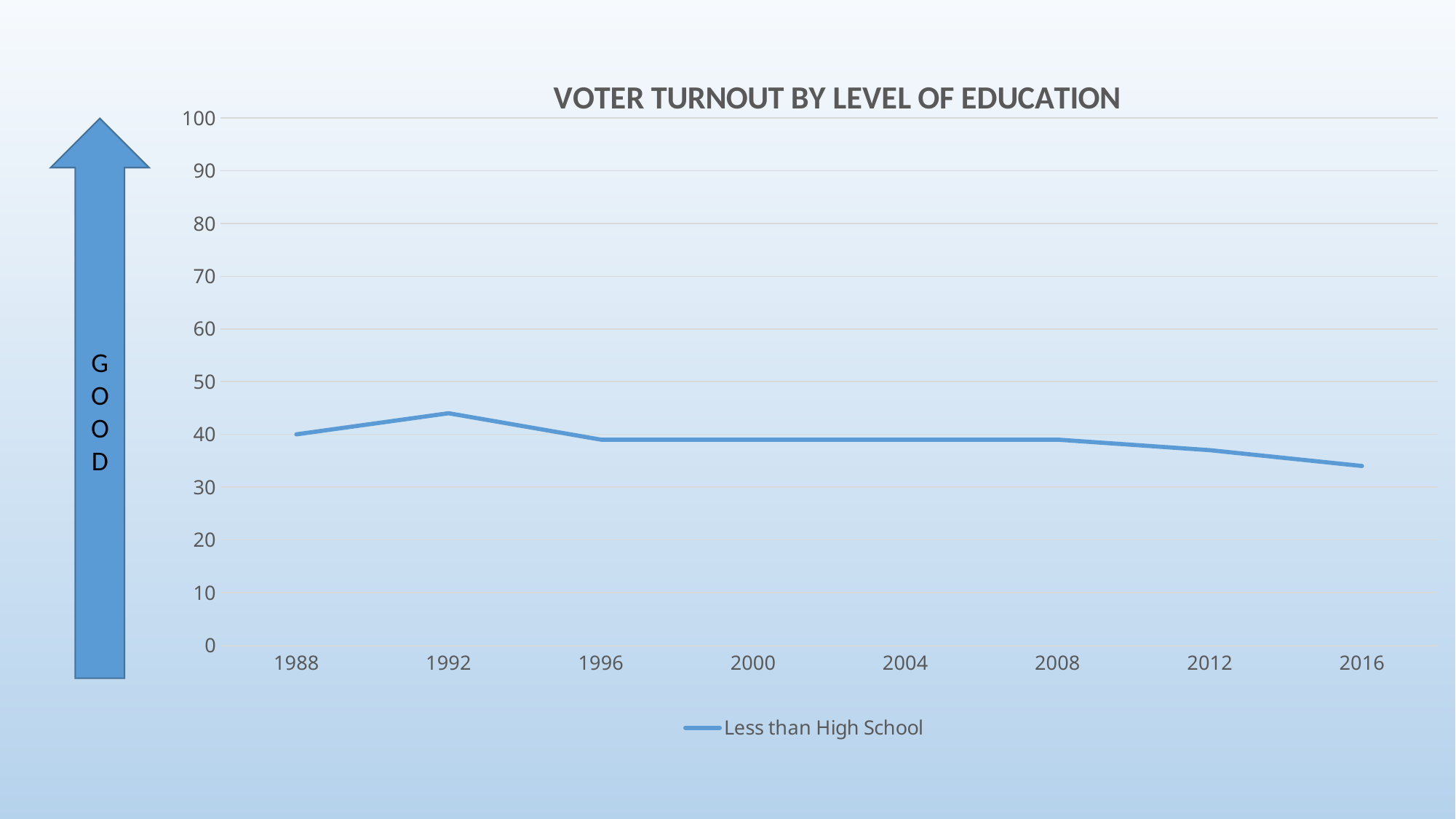
Does the Less than High School turnout rise or fall from 1992 to 2016? fall Is the value for 1988 greater or less than 50? less How many years are plotted along the x axis? 8 Is the value for 1992 greater or less than 40? greater What kind of chart is shown on the slide? line chart Which year has the larger turnout value, 1992 or 2016? 1992 In which year is the Less than High School turnout lowest? 2016 How many series does the legend list? 1 What is the title of the chart? VOTER TURNOUT BY LEVEL OF EDUCATION What series name is shown in the legend? Less than High School Is the value for 2016 greater or less than 40? less In which year is the Less than High School turnout highest? 1992